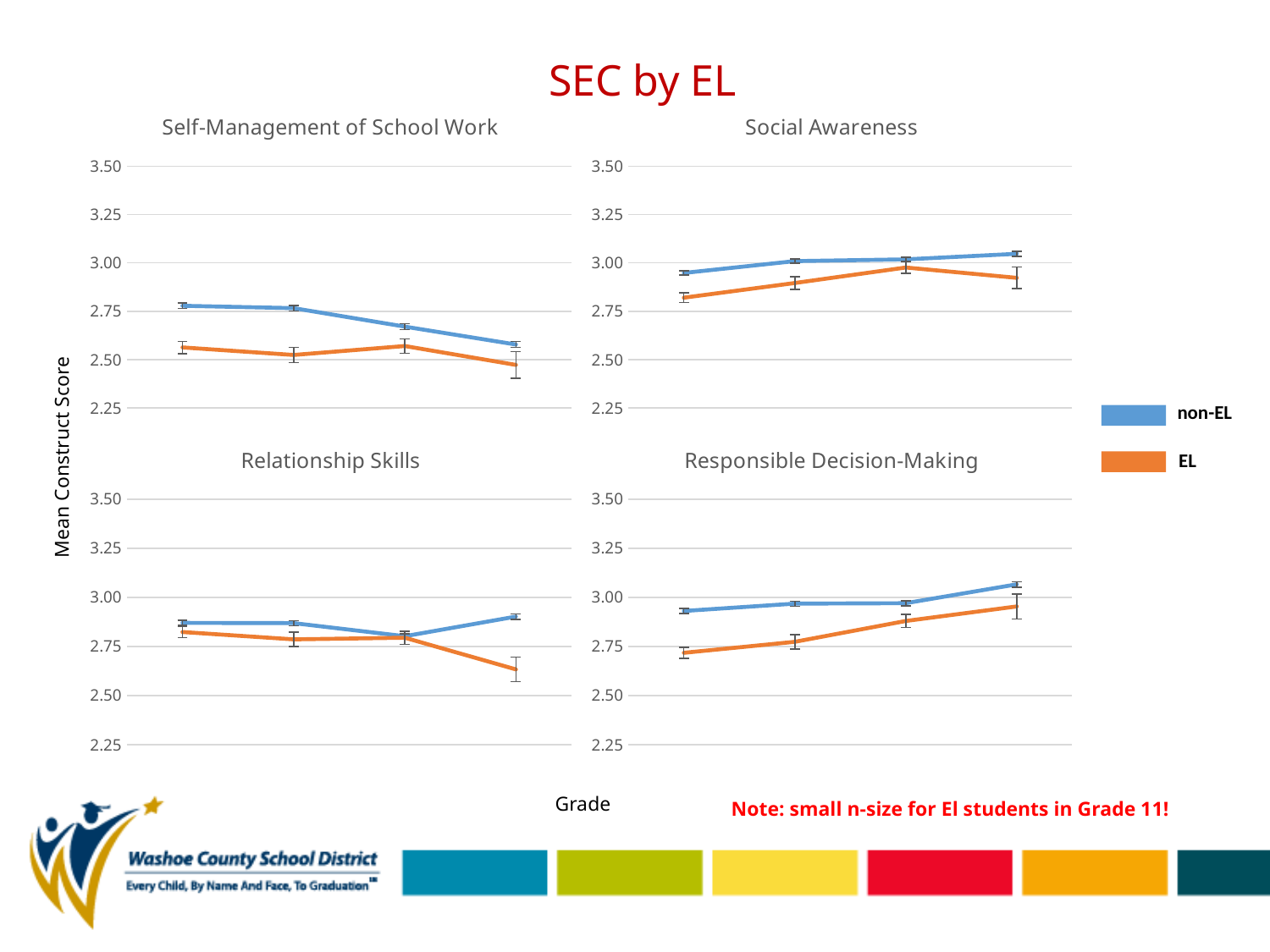
In the Relationship Skills chart, is the rightmost EL value greater or less than 2.75? less In the Self-Management of School Work chart, does the non-EL line rise or fall from left to right? fall What kind of chart is used in the Self-Management of School Work panel? line chart What are the two series named in the legend? non-EL and EL In the Self-Management of School Work chart, is the leftmost EL value greater or less than 2.75? less In the Responsible Decision-Making chart, does the EL line rise or fall from left to right? rise How many series does the legend list? 2 How many data points does each line have in the Social Awareness chart? 4 What is the title of the vertical axis shared by the charts? Mean Construct Score In the Social Awareness chart, does the non-EL line rise or fall from left to right? rise In the Social Awareness chart, is the rightmost non-EL value greater or less than 2.75? greater In the Relationship Skills chart, at the rightmost point, which series has the higher value, non-EL or EL? non-EL